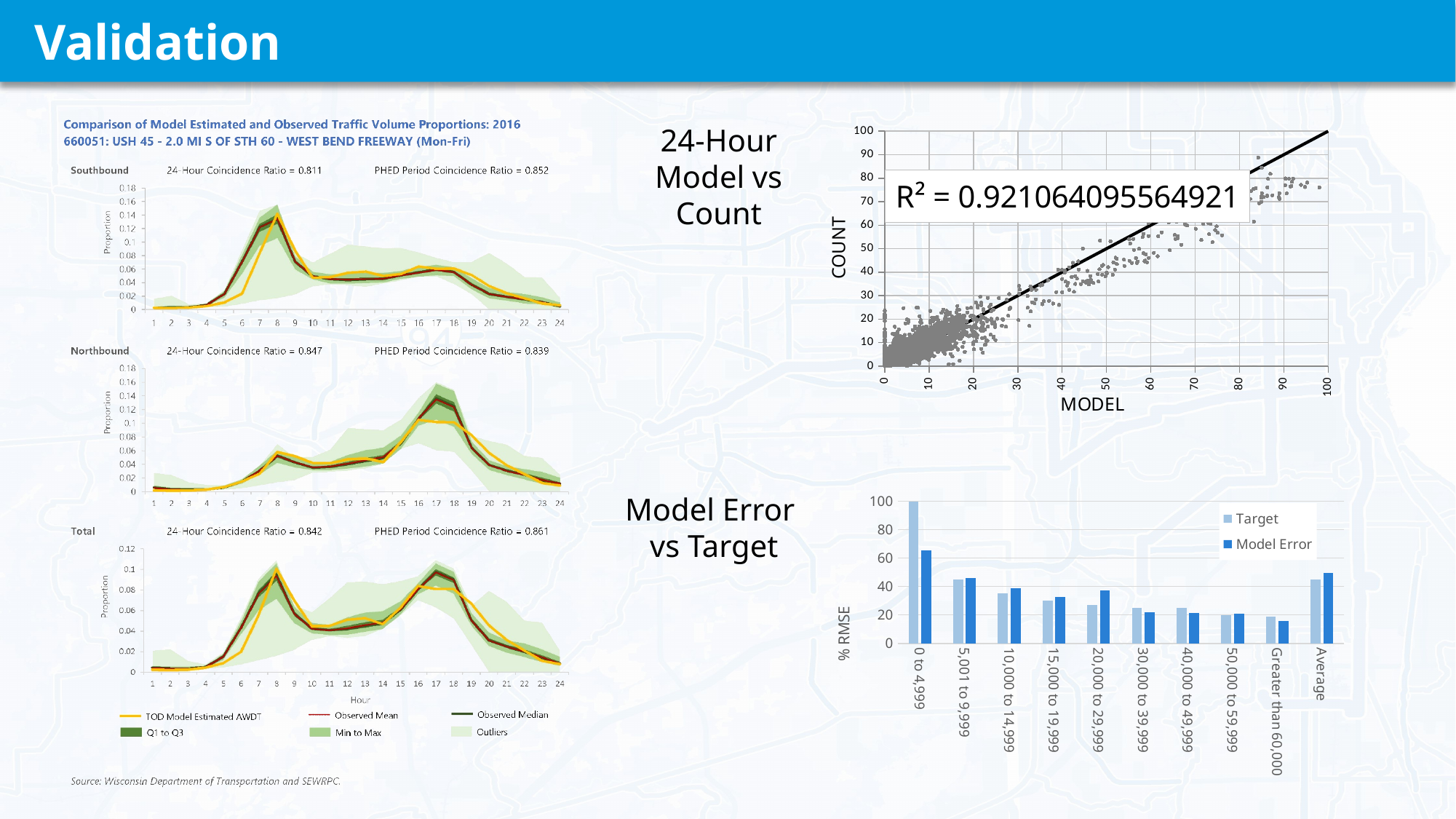
In the Model Error vs Target bar chart, how many categories are shown on the x axis? 10 In the Southbound chart on the left, what is the 24-Hour Coincidence Ratio? 0.811 What kind of chart is the 24-Hour Model vs Count chart? scatter chart In the Model Error vs Target bar chart, for the 20,000 to 29,999 category, which is larger: Target or Model Error? Model Error In the Model Error vs Target bar chart, how many series does the legend list? 2 In the Model Error vs Target bar chart, which category has the highest Target value? 0 to 4,999 What R² value is shown on the 24-Hour Model vs Count chart? R² = 0.921064095564921 In the Model Error vs Target bar chart, which category has the lowest Model Error value? Greater than 60,000 What is the label of the vertical axis on the 24-Hour Model vs Count chart? COUNT In the Model Error vs Target bar chart, is the Model Error value for 0 to 4,999 greater or less than 60? greater In the Total chart on the left, what is the PHED Period Coincidence Ratio? 0.861 In the Model Error vs Target bar chart, is the Target value for 10,000 to 14,999 greater or less than 40? less